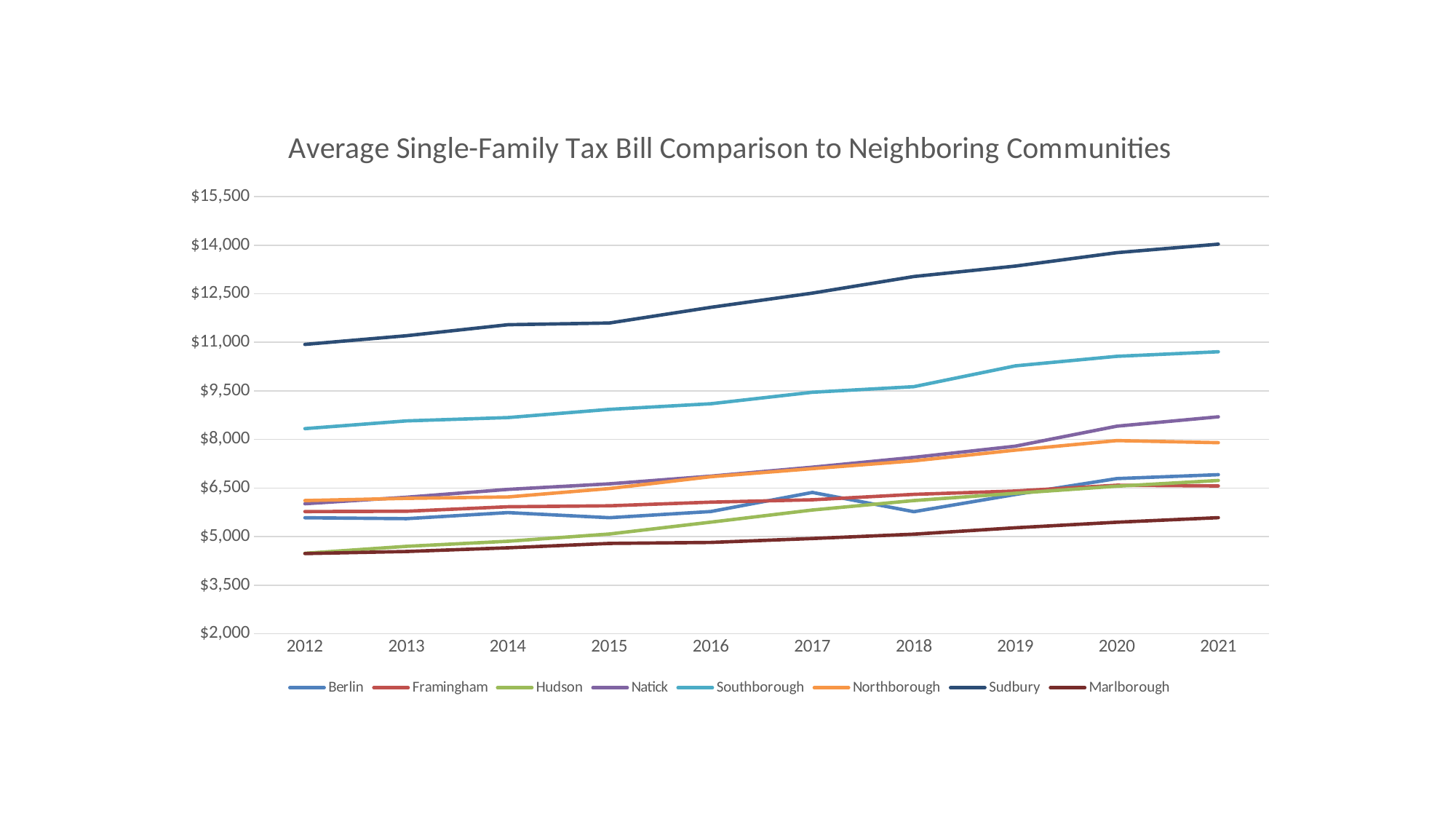
In 2021, which is larger: the value for Natick or the value for Northborough? Natick Does the Sudbury line rise or fall from 2012 to 2021? rise In 2021, which is larger: the value for Southborough or the value for Natick? Southborough Is the value for Marlborough in 2012 greater or less than $5,000? less Is the value for Sudbury in 2021 greater or less than $12,500? greater Is the value for Sudbury in 2012 greater or less than $9,500? greater Which community has the highest average single-family tax bill in 2021? Sudbury Which community has the lowest average single-family tax bill in 2021? Marlborough What is the title of the chart? Average Single-Family Tax Bill Comparison to Neighboring Communities How many communities (series) does the legend list? 8 How many years are plotted along the x axis? 10 What kind of chart is shown on the slide? line chart